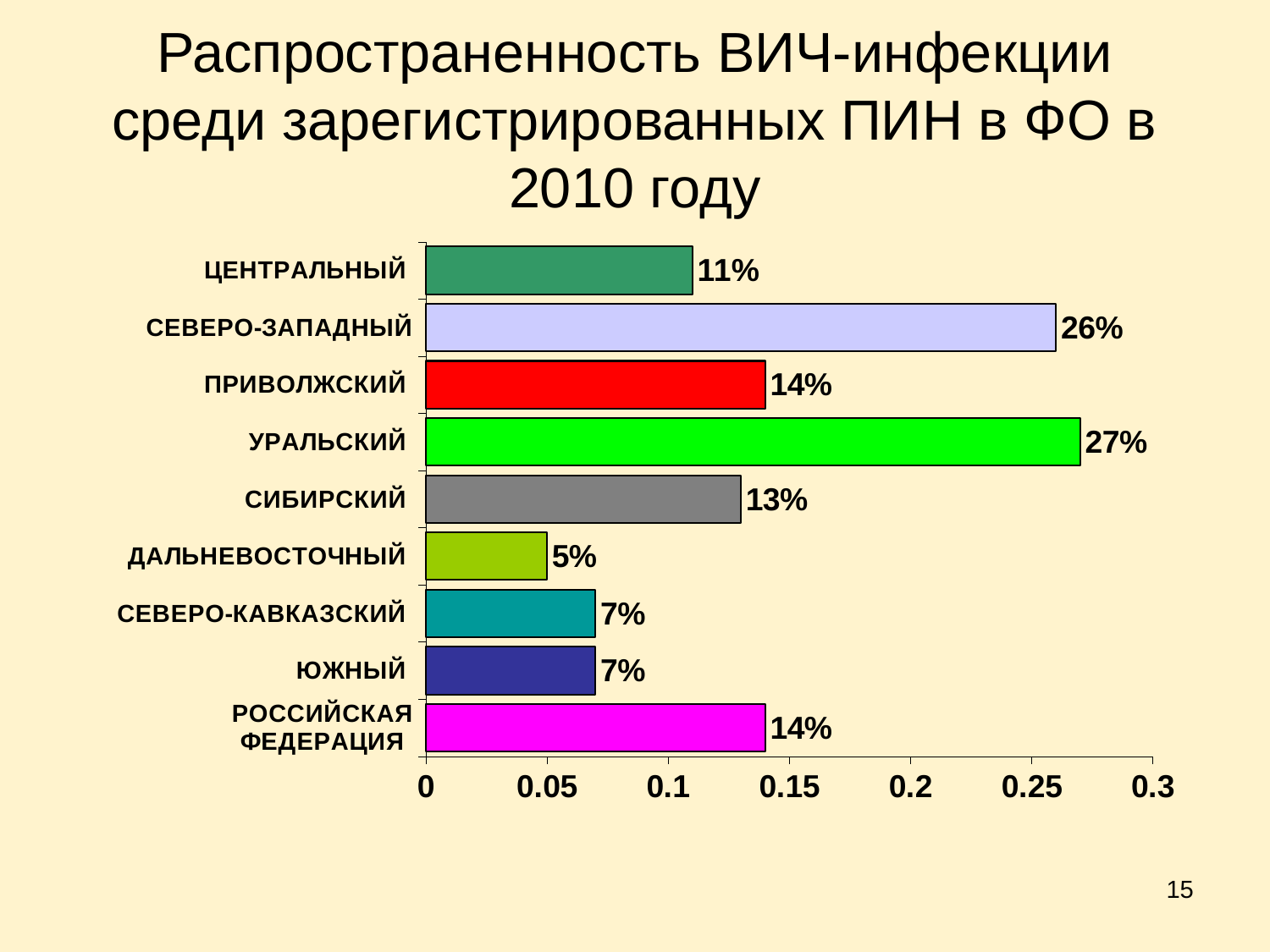
Which category has the lowest value? ДАЛЬНЕВОСТОЧНЫЙ What is the value for РОССИЙСКАЯ ФЕДЕРАЦИЯ? 14% Is the value for СЕВЕРО-ЗАПАДНЫЙ greater or less than 0.2? greater How many categories are shown in the chart? 9 What kind of chart is shown on the slide? bar chart What is the value for ДАЛЬНЕВОСТОЧНЫЙ? 5% Which category has the highest value? УРАЛЬСКИЙ What is the difference between the values for УРАЛЬСКИЙ and СИБИРСКИЙ? 14% Which is larger, the value for ПРИВОЛЖСКИЙ or the value for СИБИРСКИЙ? ПРИВОЛЖСКИЙ What is the value for СЕВЕРО-ЗАПАДНЫЙ? 26% What is the title of the chart on the slide? Распространенность ВИЧ-инфекции среди зарегистрированных ПИН в ФО в 2010 году What is the value for ЦЕНТРАЛЬНЫЙ? 11%